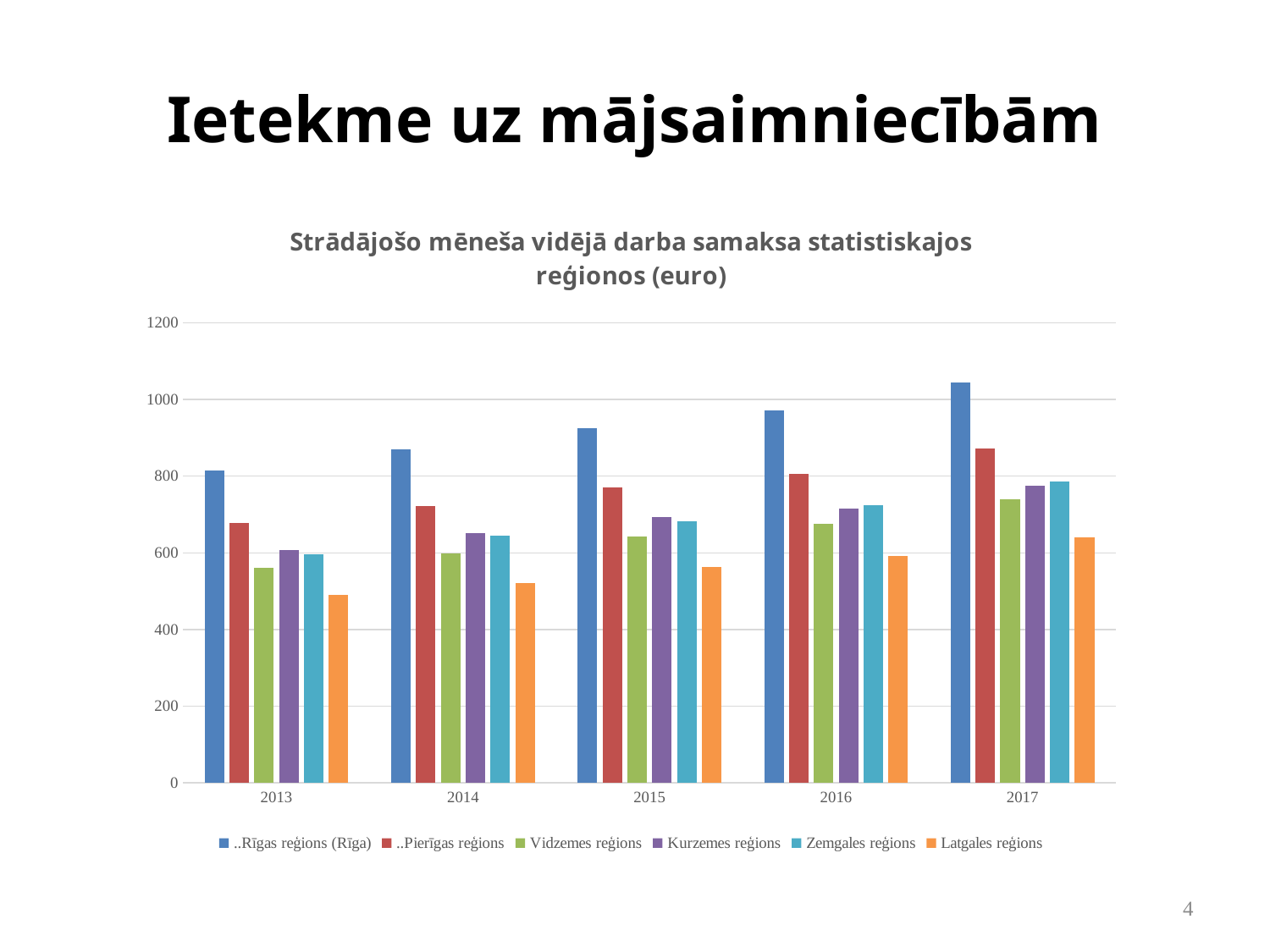
What kind of chart is shown on the slide? bar chart Which region has the lowest average monthly wage in 2013? Latgales reģions What is the title of the chart? Strādājošo mēneša vidējā darba samaksa statistiskajos reģionos (euro) Which region has the highest average monthly wage in 2017? ..Rīgas reģions (Rīga) Is the value for Latgales reģions in 2013 greater or less than 600? less Is the value for Vidzemes reģions in 2017 greater or less than 800? less How many series does the legend list? 6 Is the value for ..Rīgas reģions (Rīga) in 2017 greater or less than 1000? greater What colour represents Latgales reģions in the chart? orange In 2016, which is larger: the value for ..Pierīgas reģions or for Vidzemes reģions? ..Pierīgas reģions Do the values for ..Rīgas reģions (Rīga) rise or fall from 2013 to 2017? rise How many years are shown on the x axis? 5